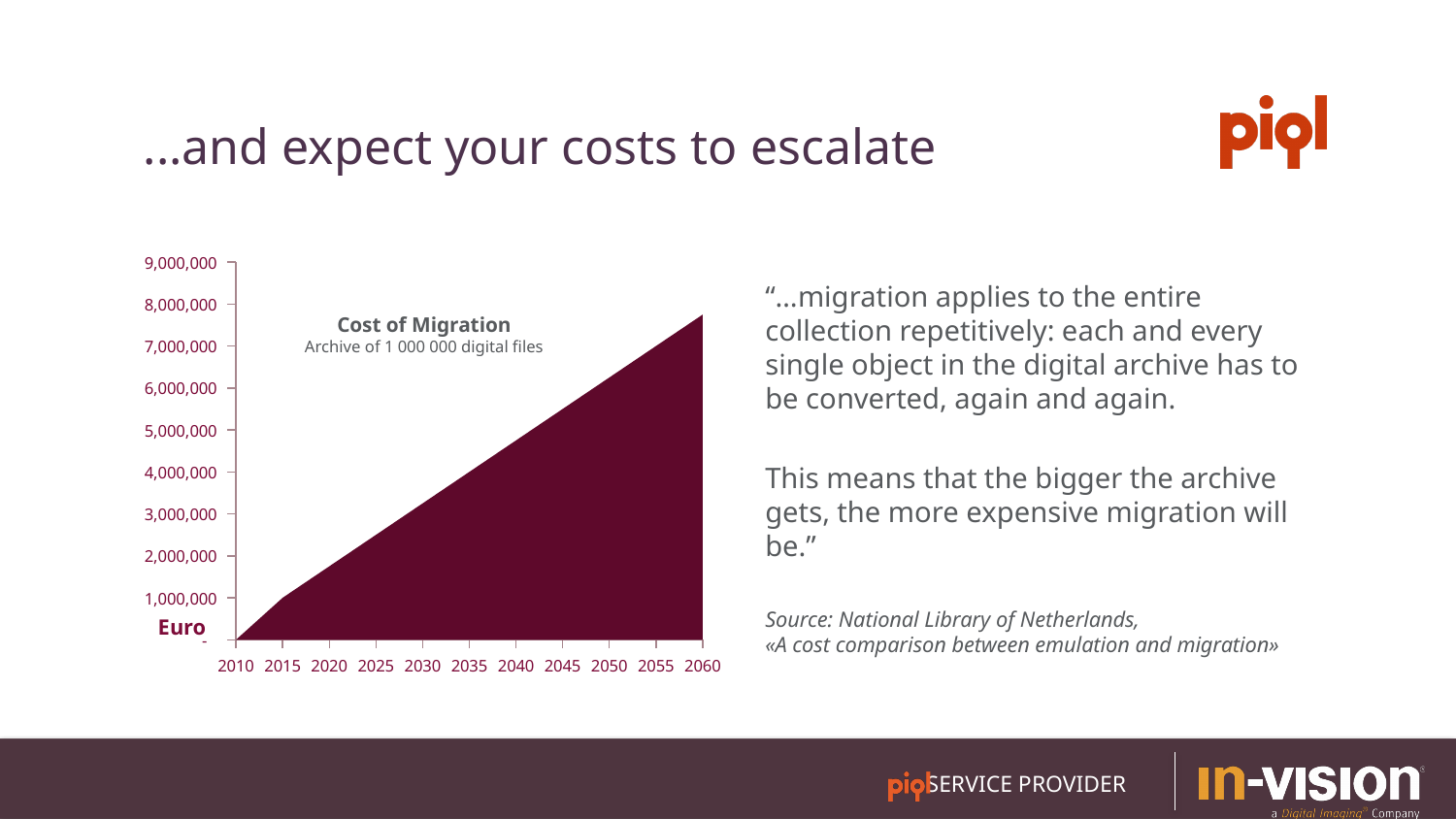
What is the title of the chart? Cost of Migration Is the value for 2020 greater or less than 2,000,000? less Which year has the larger cost of migration, 2030 or 2050? 2050 Is the value for 2040 greater or less than 4,000,000? greater How many year labels are shown on the x axis of the chart? 11 What unit is shown on the vertical axis of the chart? Euro Do the values in the chart rise or fall from 2010 to 2060? rise In which year is the cost of migration lowest? 2010 What kind of chart is shown on the slide? area chart Is the value for 2050 greater or less than 5,000,000? greater In which year is the cost of migration highest? 2060